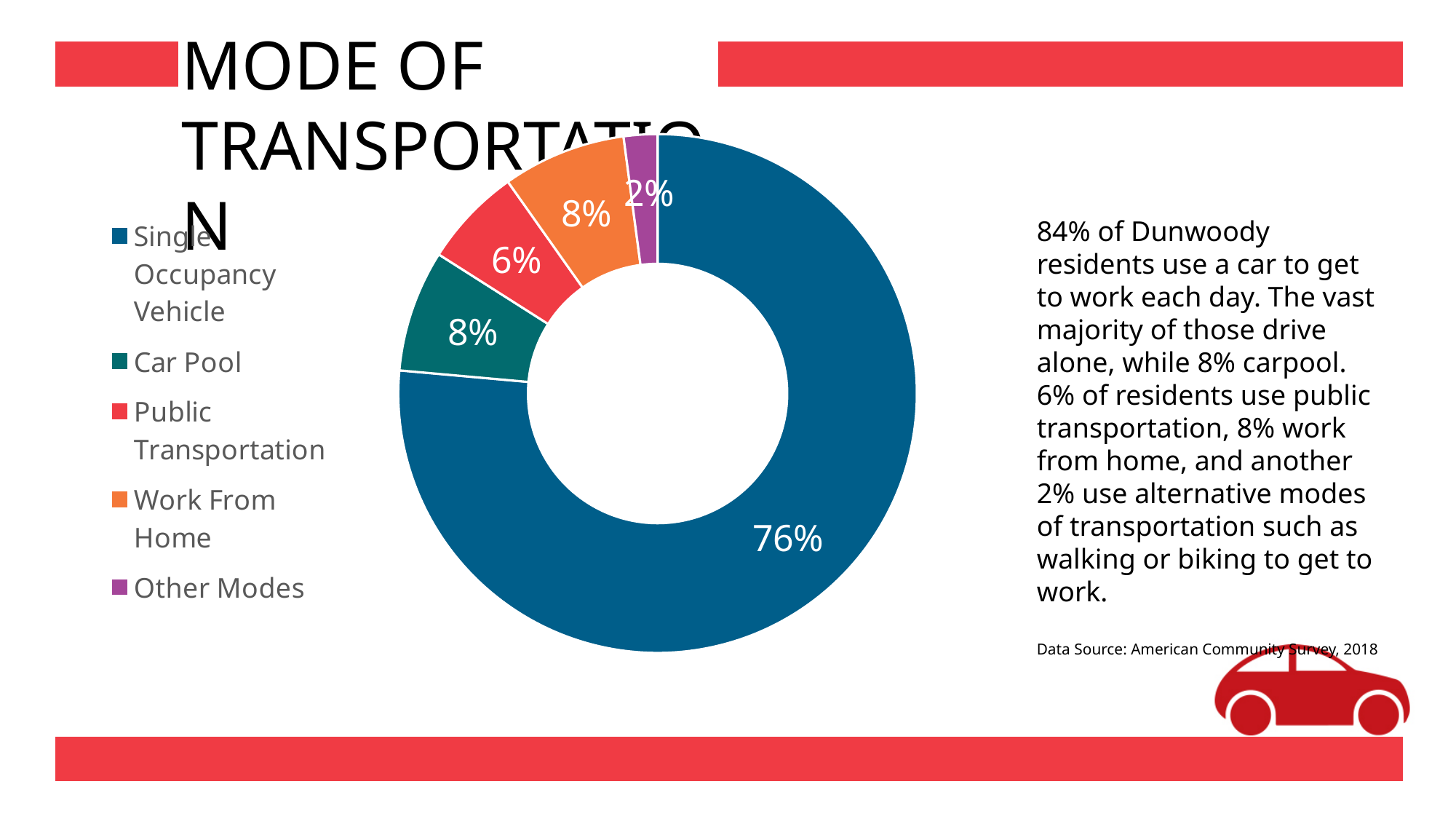
What kind of chart is shown on the slide? Pie chart (doughnut) Which category has the largest share? Single Occupancy Vehicle What is the difference between the Single Occupancy Vehicle share and the Car Pool share? 68% What is the value for Work From Home? 8% How many categories does the chart show? 5 What is the value for Car Pool? 8% What share of the pie does Single Occupancy Vehicle represent? 76% What is the value for Public Transportation? 6% What is the value for Other Modes? 2% Which category has the smallest share? Other Modes What colour is the Public Transportation slice? Red